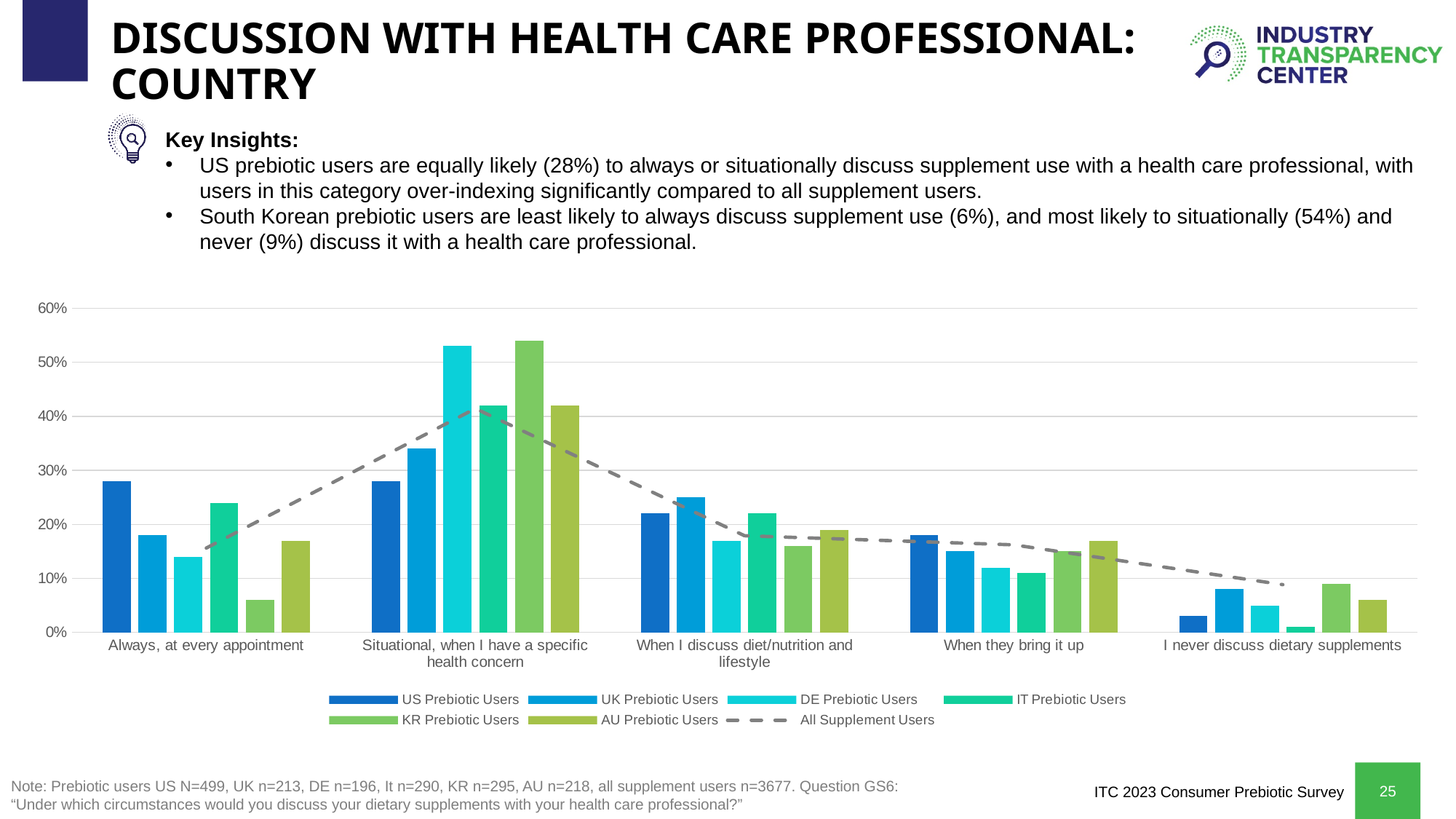
Is the value for UK Prebiotic Users in the 'Situational, when I have a specific health concern' category greater or less than 30%? greater In the 'Situational, when I have a specific health concern' category, which is larger: DE Prebiotic Users or IT Prebiotic Users? DE Prebiotic Users Which country's prebiotic users have the lowest bar in the 'I never discuss dietary supplements' category? IT Prebiotic Users What is the value for US Prebiotic Users in the 'Always, at every appointment' category? 28% How many response categories are shown along the x axis? 5 Which country's prebiotic users have the highest bar in the 'Always, at every appointment' category? US Prebiotic Users What kind of chart is shown on the slide? combination bar and line chart How many series does the legend list? 7 What is the value for KR Prebiotic Users in the 'Situational, when I have a specific health concern' category? 54% Is the value for AU Prebiotic Users in the 'Always, at every appointment' category greater or less than 20%? less Which series is drawn as a dashed line rather than bars? All Supplement Users Which country's prebiotic users have the lowest bar in the 'Always, at every appointment' category? KR Prebiotic Users